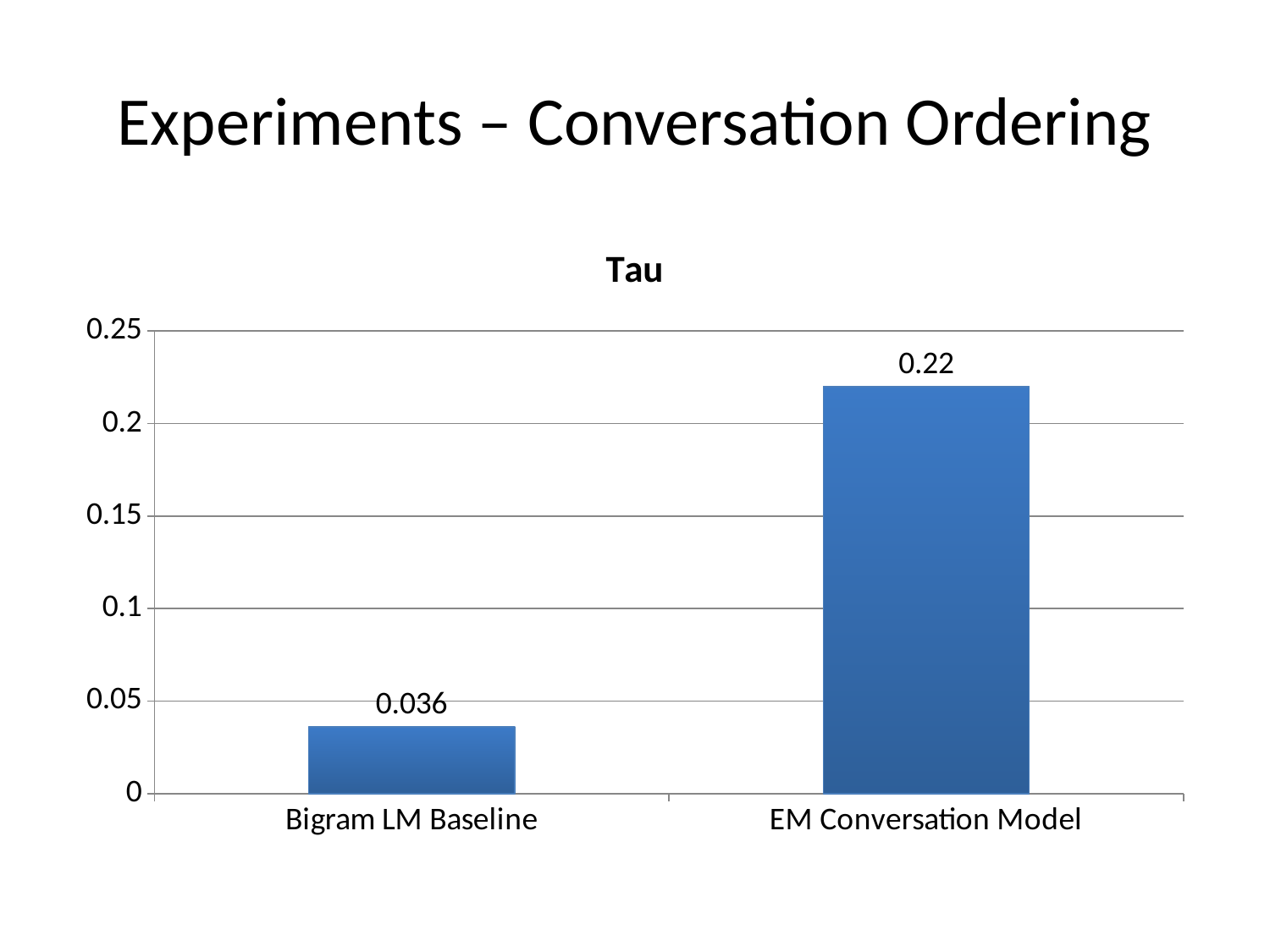
Is the Tau value for EM Conversation Model greater or less than 0.2? greater How many categories are shown in the chart? 2 What is the Tau value for EM Conversation Model? 0.22 What is the difference in Tau between EM Conversation Model and Bigram LM Baseline? 0.184 Which category has the lowest Tau value? Bigram LM Baseline What is the maximum value shown on the vertical axis? 0.25 What is the Tau value for Bigram LM Baseline? 0.036 Which category has the highest Tau value? EM Conversation Model What is the title of the chart? Tau Which has a larger Tau value, Bigram LM Baseline or EM Conversation Model? EM Conversation Model Is the Tau value for Bigram LM Baseline greater or less than 0.05? less What kind of chart is shown on the slide? bar chart